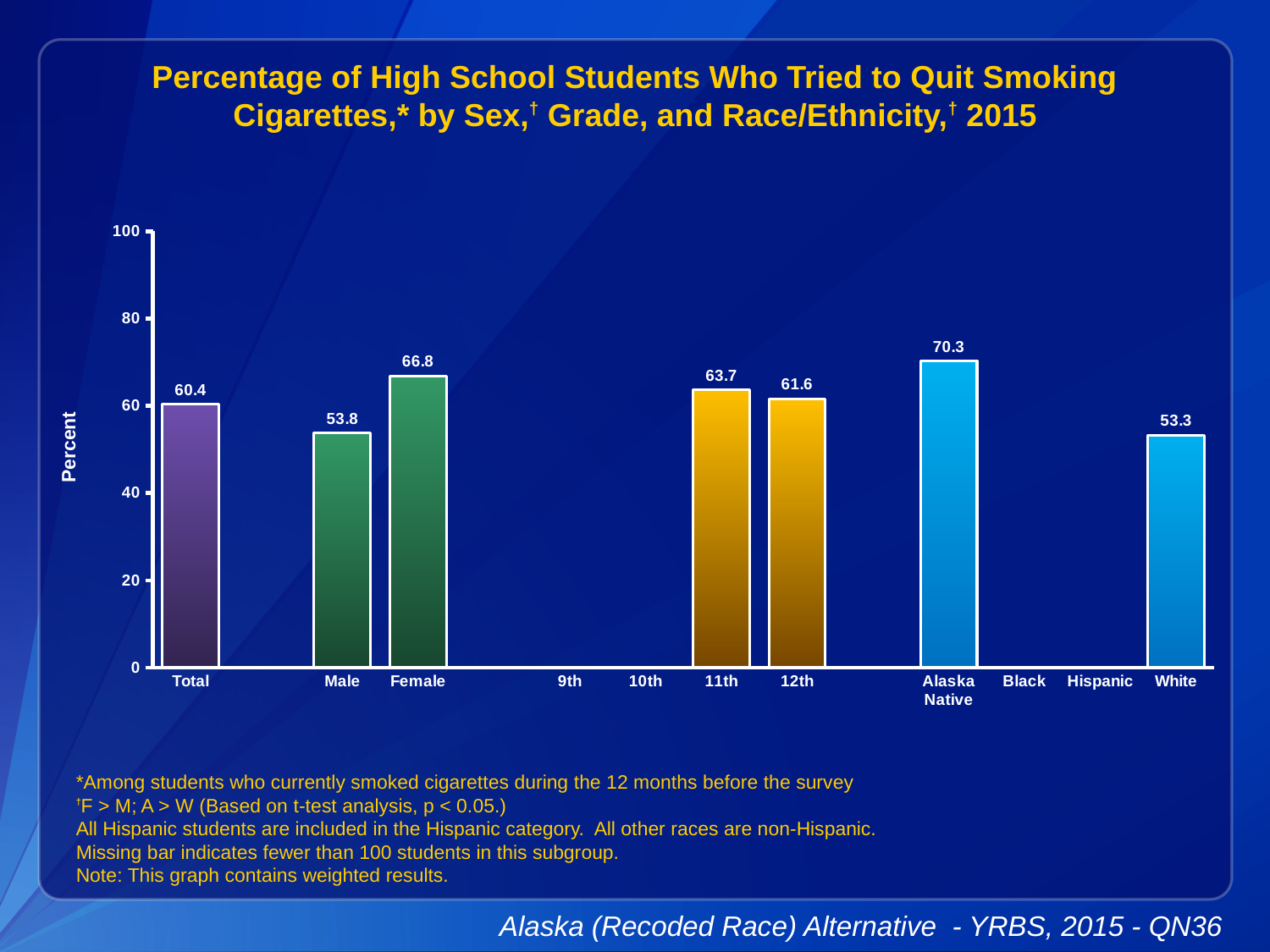
What is the value for Alaska Native? 70.3 How many categories are labelled on the x axis? 11 Which category has the highest value? Alaska Native Which category with a bar has the lowest value? White What is the difference between the Female and Male values? 13.0 What is the value for Total? 60.4 What is the value for Female? 66.8 What kind of chart is this? bar chart What is the label of the y axis? Percent Is the value for Male greater or less than 60? less Which is larger, the value for 11th or the value for 12th? 11th How many categories have no bar shown? 4